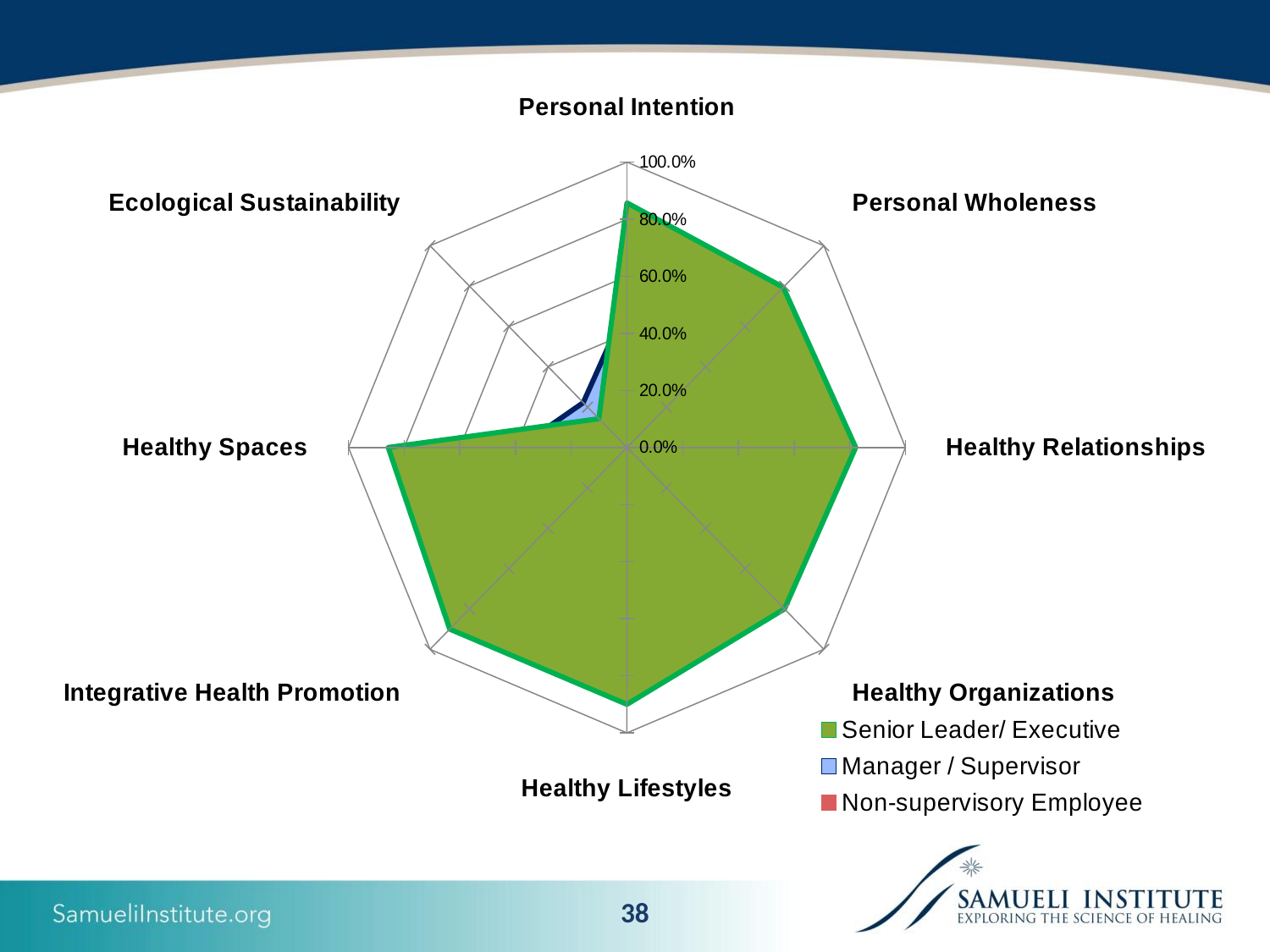
Is the Senior Leader/ Executive value for Personal Wholeness greater or less than 60.0%? greater What is the maximum value shown on the radar chart's scale? 100.0% Is the Senior Leader/ Executive value for Healthy Relationships greater or less than 60.0%? greater How many series does the legend list? 3 For the Senior Leader/ Executive series, which is larger: Healthy Lifestyles or Ecological Sustainability? Healthy Lifestyles For the Senior Leader/ Executive series, which is larger: Ecological Sustainability or Healthy Spaces? Healthy Spaces Which category has the lowest value for the Senior Leader/ Executive series? Ecological Sustainability Is the Senior Leader/ Executive value for Healthy Lifestyles greater or less than 80.0%? greater What kind of chart is shown on the slide? Radar chart How many categories (axes) does the radar chart have? 8 Which series is shown in green in the legend? Senior Leader/ Executive